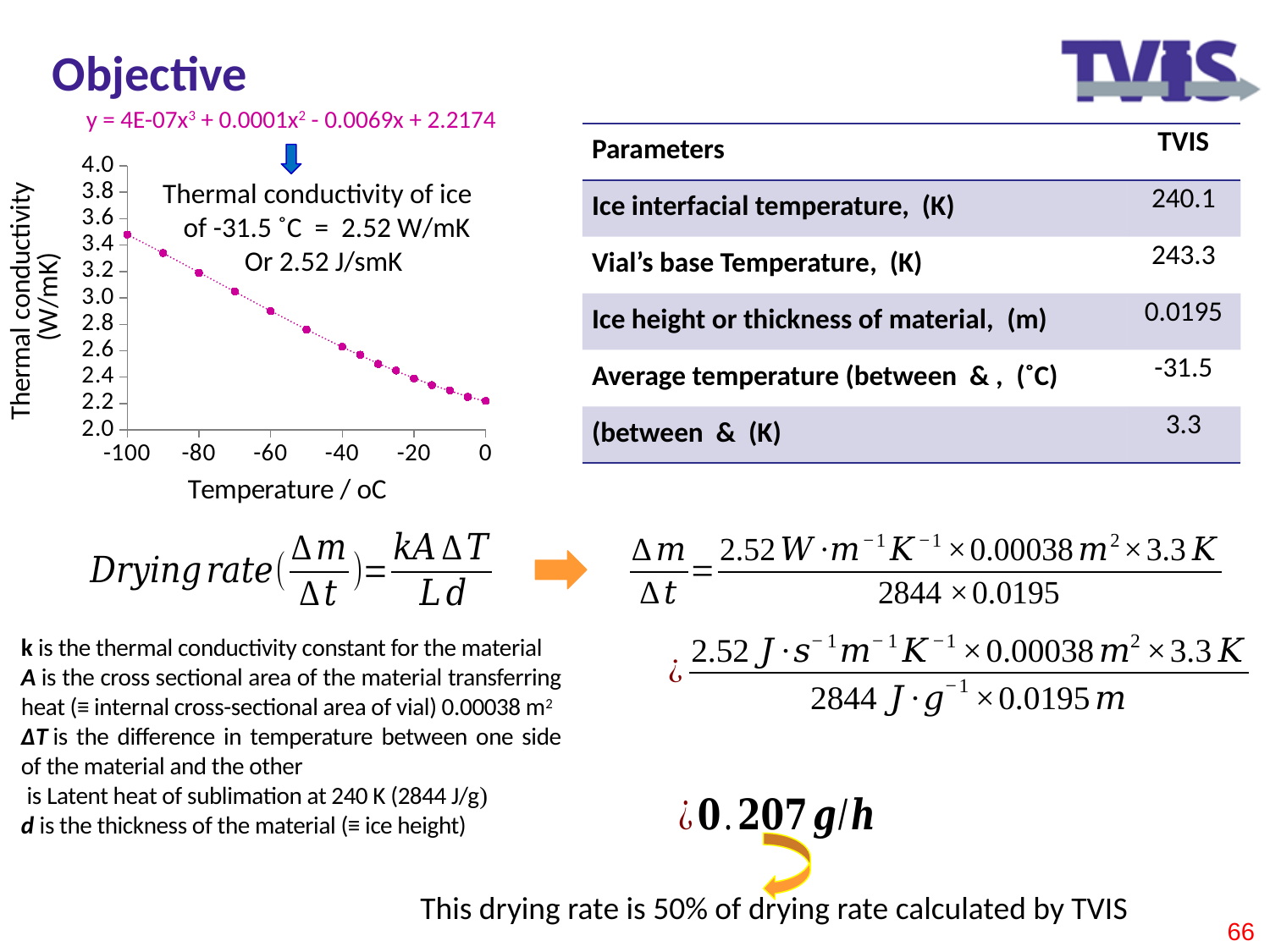
Do the thermal conductivity values rise or fall as temperature increases from -100 to 0 along the x axis? fall Which has the higher thermal conductivity, -80 °C or -40 °C? -80 °C Is the thermal conductivity at -100 °C greater or less than 3.4 W/mK? greater Is the thermal conductivity at -60 °C greater or less than 2.8 W/mK? greater What fitted equation is printed above the chart? y = 4E-07x³ + 0.0001x² - 0.0069x + 2.2174 According to the annotation on the chart, what is the thermal conductivity of ice at -31.5 °C in W/mK? 2.52 W/mK What kind of chart is shown on the slide? scatter chart Is the thermal conductivity at 0 °C greater or less than 2.4 W/mK? less At which temperature on the x axis is the thermal conductivity lowest? 0 At which temperature on the x axis is the thermal conductivity highest? -100 What is the label of the y axis of the chart? Thermal conductivity (W/mK)